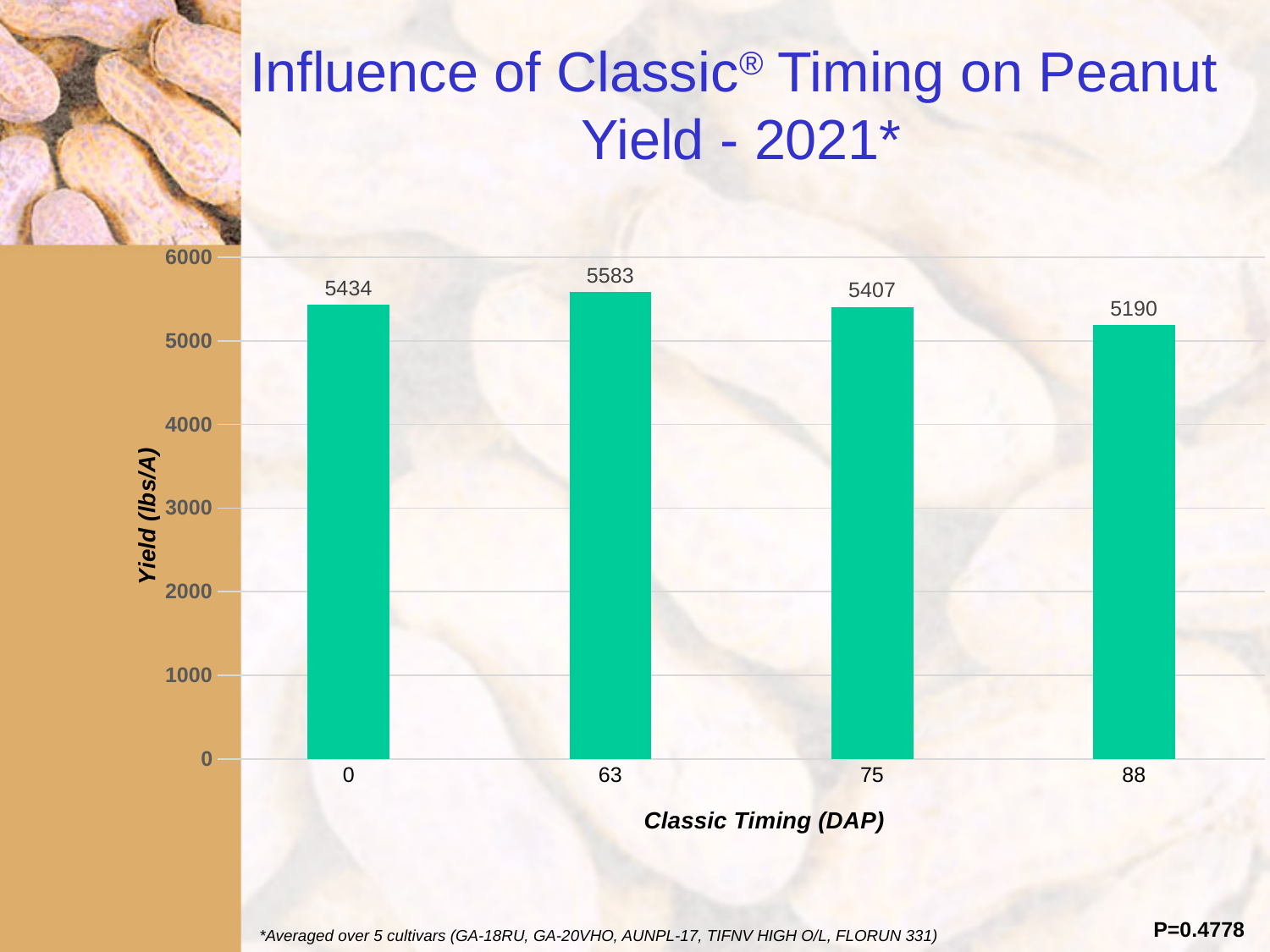
What is the yield for Classic timing of 88 DAP? 5190 How many Classic timing categories are shown on the chart? 4 Is the yield for 88 DAP greater or less than 5000? greater Which Classic timing has the lowest yield? 88 What is the label of the y axis? Yield (lbs/A) What is the yield for Classic timing of 63 DAP? 5583 What is the difference in yield between 0 DAP and 75 DAP? 27 Which Classic timing has the highest yield? 63 Which has a larger yield, 63 DAP or 88 DAP? 63 DAP What is the difference in yield between 63 DAP and 88 DAP? 393 What kind of chart is shown on the slide? bar chart What is the yield for Classic timing of 0 DAP? 5434